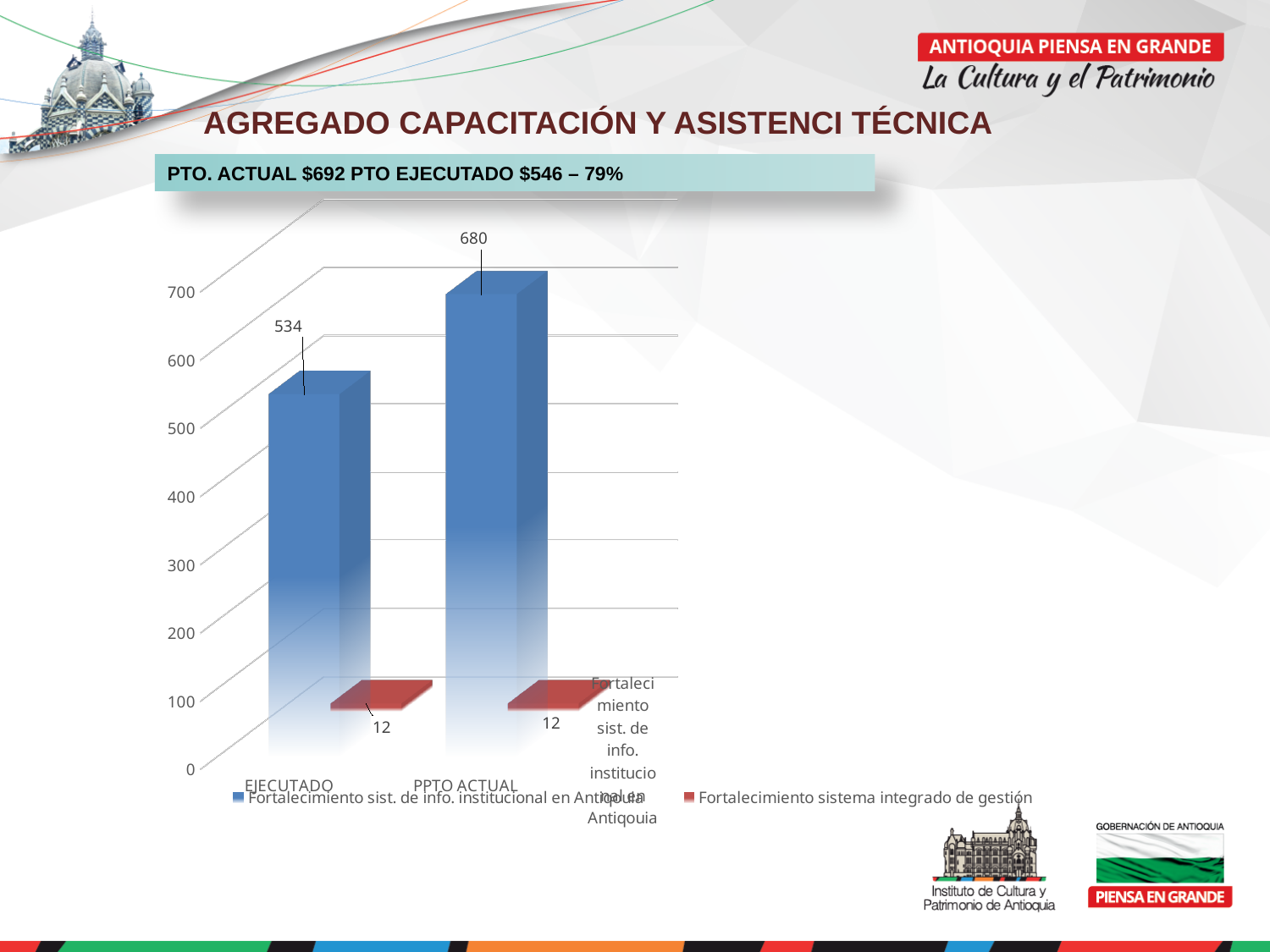
How many series does the chart legend list? 2 What is the value for PPTO ACTUAL in the series Fortalecimiento sistema integrado de gestión? 12 What is the difference between the PPTO ACTUAL and EJECUTADO values in the series Fortalecimiento sist. de info. institucional en Antioquia? 146 What is the value for EJECUTADO in the series Fortalecimiento sist. de info. institucional en Antioquia? 534 Which is larger: the EJECUTADO value for Fortalecimiento sist. de info. institucional en Antioquia or the EJECUTADO value for Fortalecimiento sistema integrado de gestión? Fortalecimiento sist. de info. institucional en Antioquia Is the EJECUTADO value for Fortalecimiento sist. de info. institucional en Antioquia greater or less than 500? greater What is the value for PPTO ACTUAL in the series Fortalecimiento sist. de info. institucional en Antioquia? 680 What kind of chart is shown on the slide? bar chart Which category has the higher value in the series Fortalecimiento sist. de info. institucional en Antioquia? PPTO ACTUAL How many categories are shown on the x axis of the chart? 2 What is the value for EJECUTADO in the series Fortalecimiento sistema integrado de gestión? 12 What colour are the bars for the series Fortalecimiento sistema integrado de gestión? red